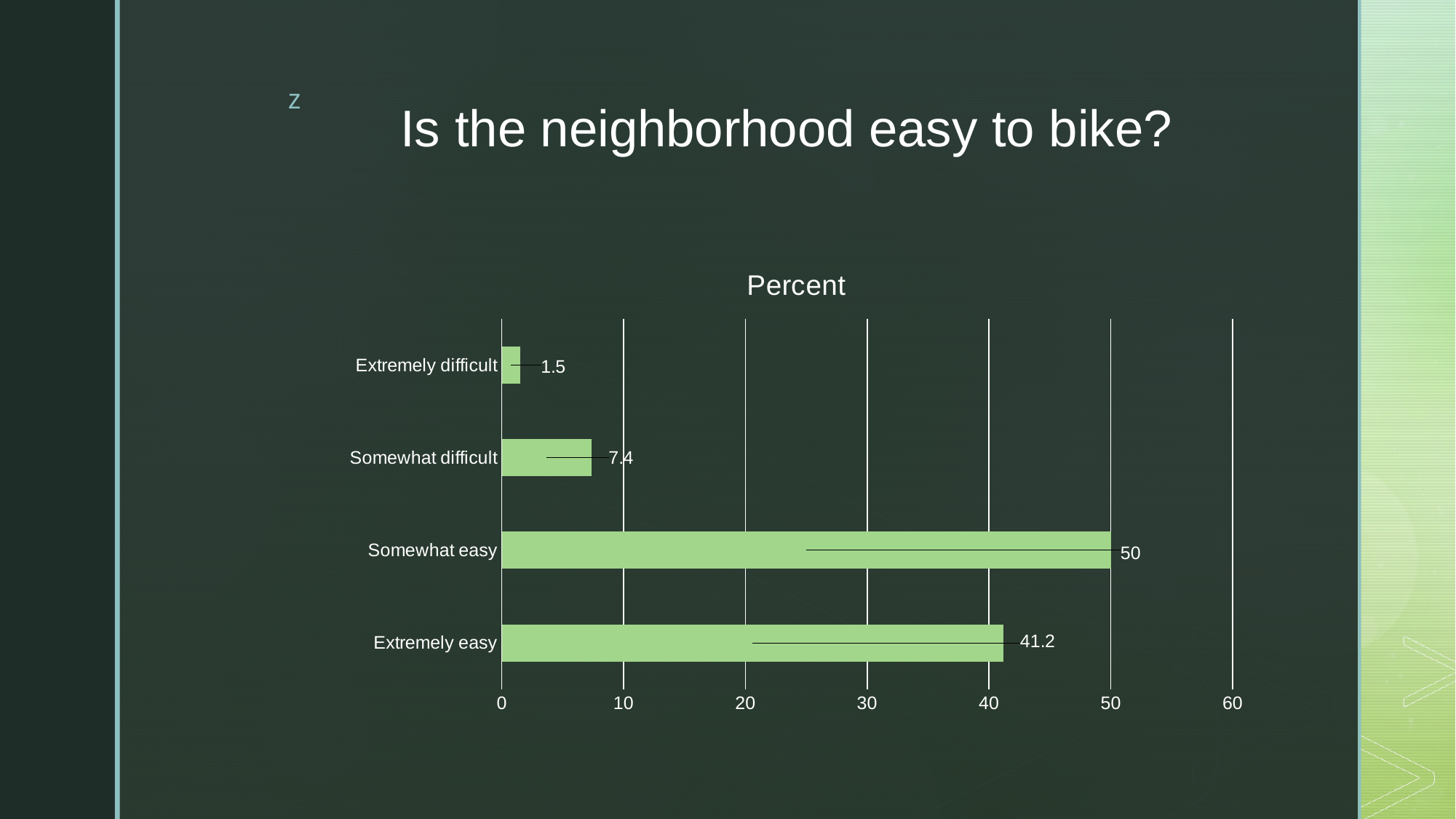
What is the title of the chart? Percent What is the difference between the values for Somewhat easy and Extremely easy? 8.8 Which category has the lowest value? Extremely difficult Which is larger, the value for Extremely easy or the value for Somewhat difficult? Extremely easy What is the value for Somewhat easy? 50 How many categories are shown in the chart? 4 Which category has the highest value? Somewhat easy What kind of chart is shown on the slide? Bar chart What is the value for Extremely difficult? 1.5 What is the value for Somewhat difficult? 7.4 What is the difference between the values for Somewhat difficult and Extremely difficult? 5.9 What is the value for Extremely easy? 41.2